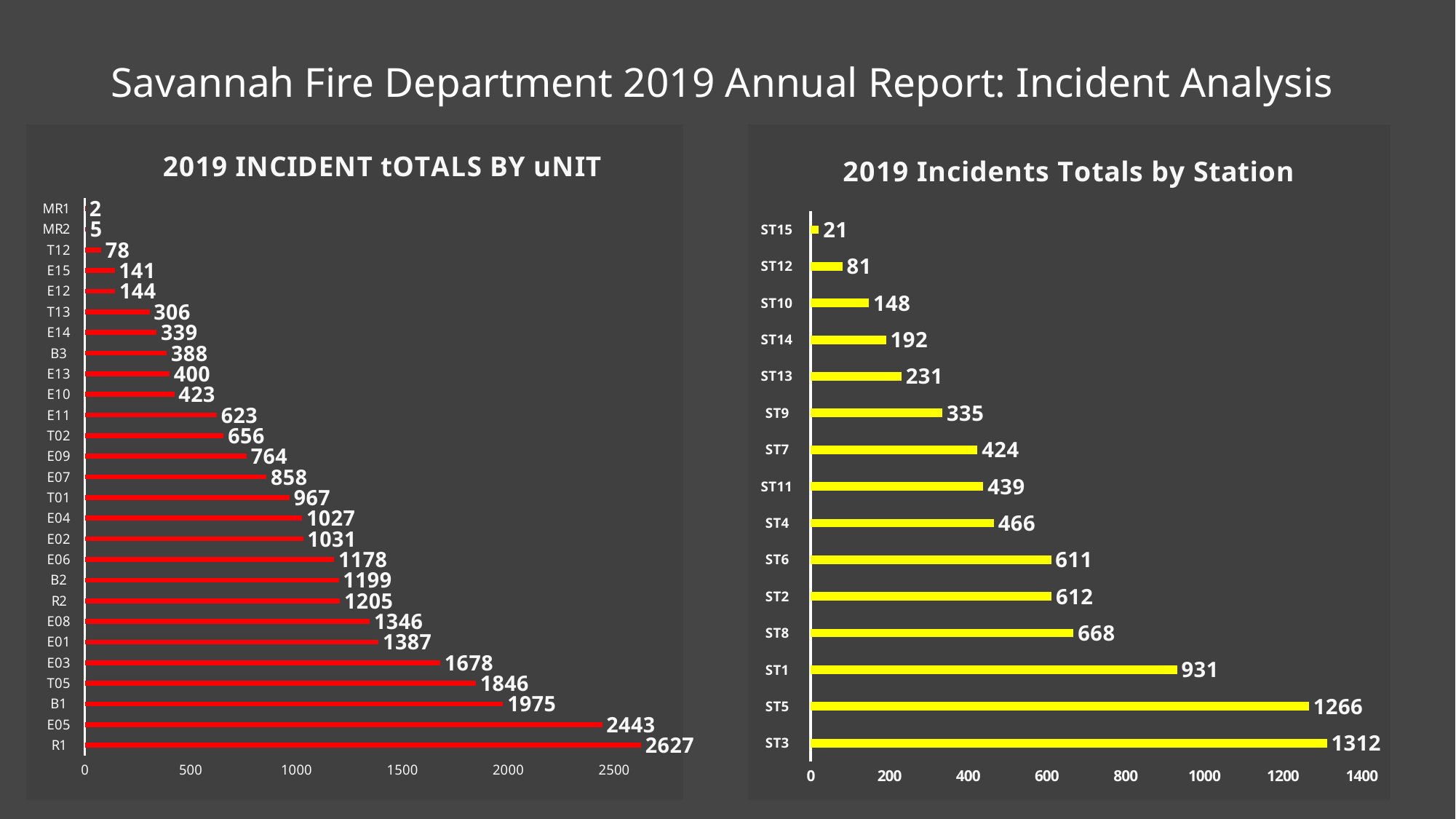
In the '2019 Incidents Totals by Station' chart, which station has the highest total? ST3 In the '2019 Incident Totals by Unit' chart, which unit has the lowest incident total? MR1 In the '2019 Incident Totals by Unit' chart, which has more incidents, T05 or E03? T05 How many stations are shown in the '2019 Incidents Totals by Station' chart? 15 In the '2019 Incidents Totals by Station' chart, what is the difference between the totals for ST3 and ST5? 46 In the '2019 Incident Totals by Unit' chart, how many incidents did unit E05 have? 2443 In the '2019 Incidents Totals by Station' chart, how many incidents did ST1 have? 931 In the '2019 Incidents Totals by Station' chart, which station has the lowest total? ST15 In the '2019 Incident Totals by Unit' chart, what is the difference between the totals for R1 and E05? 184 How many units are shown in the '2019 Incident Totals by Unit' chart? 27 What type of chart is the '2019 Incidents Totals by Station' chart? Bar chart In the '2019 Incident Totals by Unit' chart, which unit has the highest incident total? R1